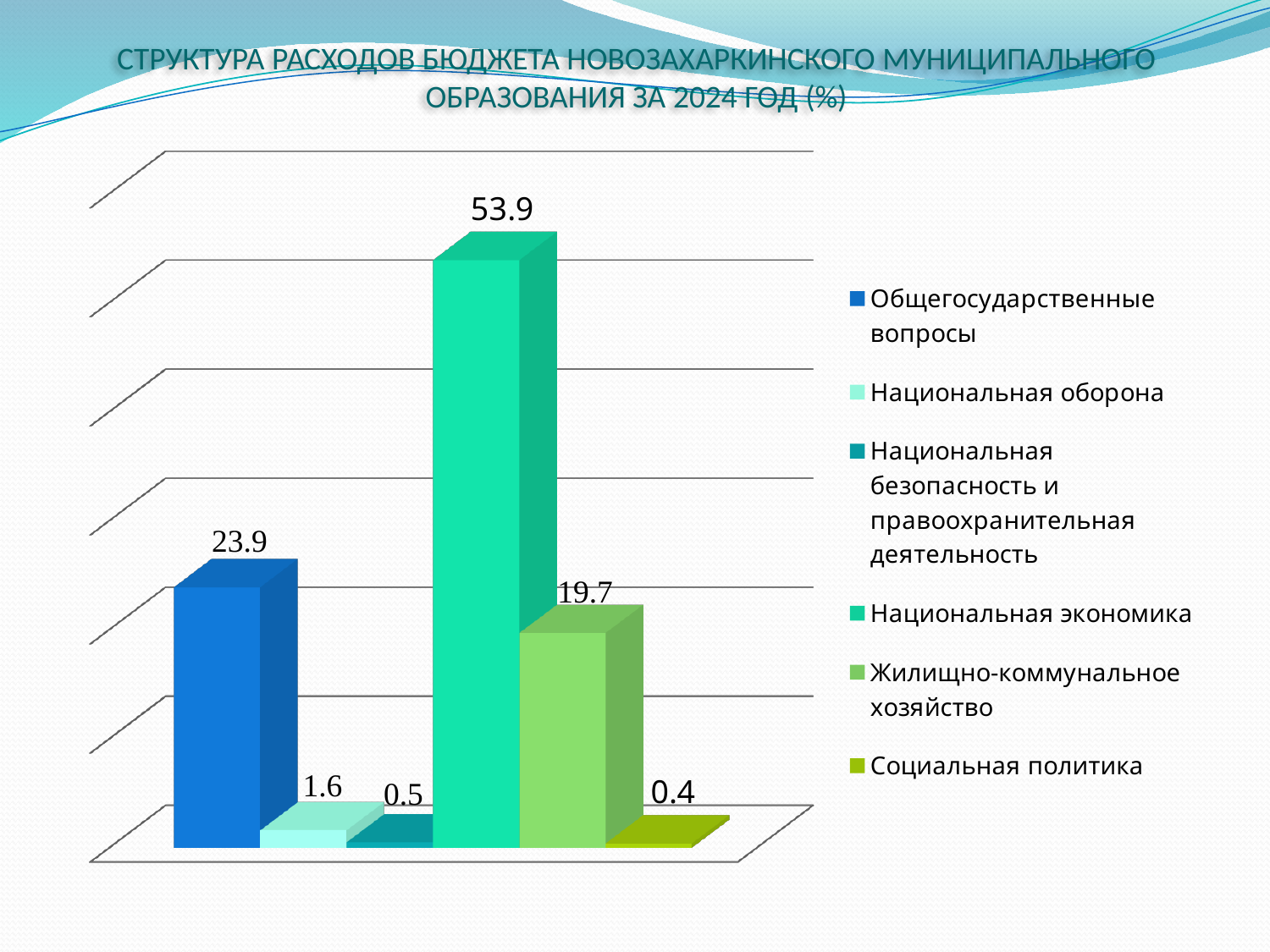
What is the value for Социальная политика? 0.4 Which category has the lowest value? Социальная политика What colour is the bar for Общегосударственные вопросы? Blue How many entries does the legend list? 6 What is the value for Национальная экономика? 53.9 What is the value for Жилищно-коммунальное хозяйство? 19.7 Which is larger, the value for Общегосударственные вопросы or the value for Жилищно-коммунальное хозяйство? Общегосударственные вопросы What is the value for Общегосударственные вопросы? 23.9 What is the difference between the values for Национальная экономика and Общегосударственные вопросы? 30 Which category has the highest value? Национальная экономика What is the value for Национальная оборона? 1.6 What kind of chart is shown on the slide? Bar chart